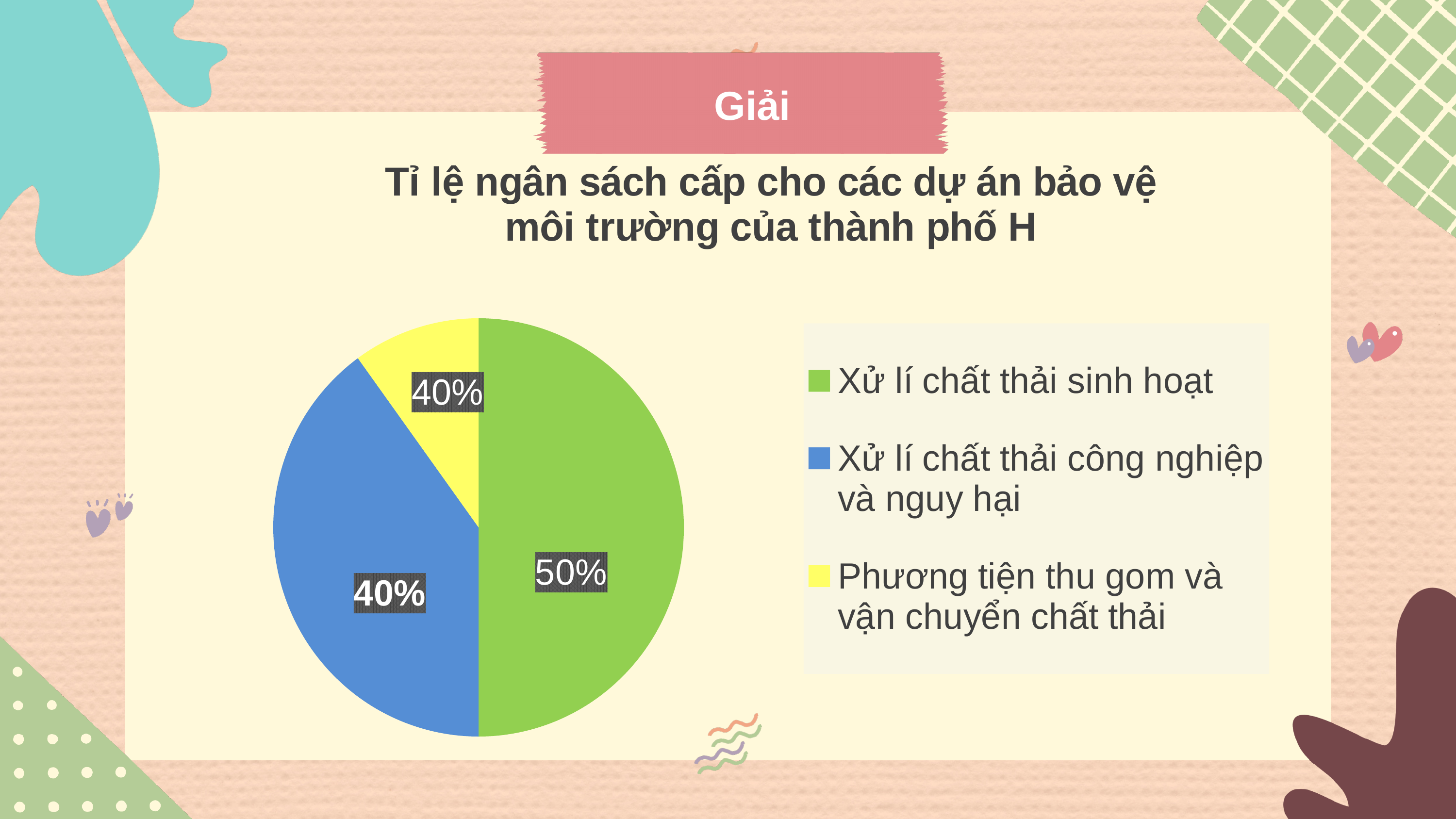
How many entries does the legend list? 3 What is the difference between the percentage for Xử lí chất thải sinh hoạt and the percentage for Xử lí chất thải công nghiệp và nguy hại? 10% How many slices does the pie chart have? 3 What colour is the slice for Phương tiện thu gom và vận chuyển chất thải? yellow Which is larger, the slice for Xử lí chất thải sinh hoạt or the slice for Xử lí chất thải công nghiệp và nguy hại? Xử lí chất thải sinh hoạt What percentage is shown for Xử lí chất thải công nghiệp và nguy hại? 40% What percentage is shown for Xử lí chất thải sinh hoạt? 50% Which category has the largest slice of the pie? Xử lí chất thải sinh hoạt What kind of chart is shown on the slide? pie chart What is the title of the chart? Tỉ lệ ngân sách cấp cho các dự án bảo vệ môi trường của thành phố H